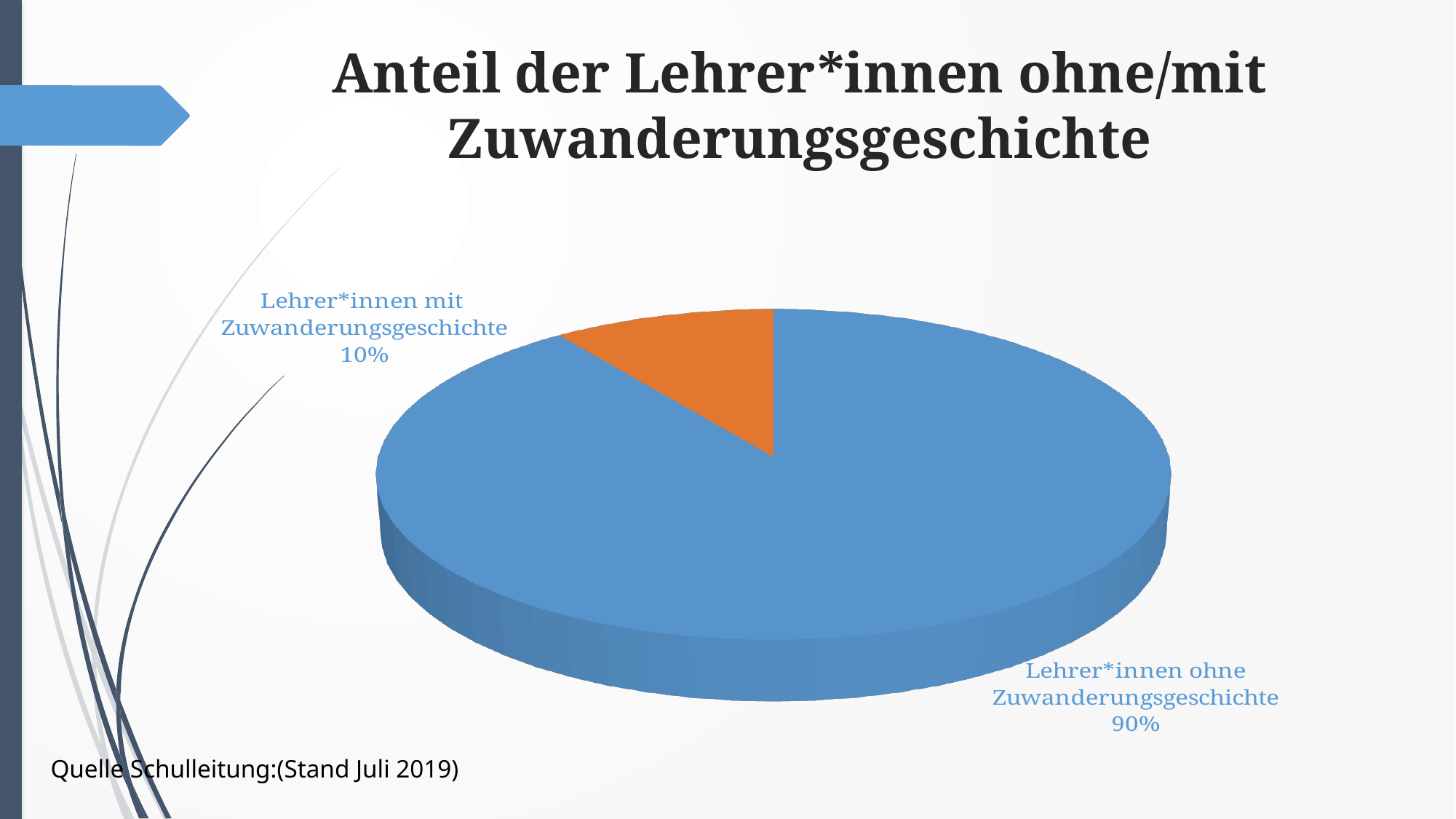
What kind of chart is shown on the slide? Pie chart What is the difference in percentage points between the share of Lehrer*innen ohne Zuwanderungsgeschichte and Lehrer*innen mit Zuwanderungsgeschichte? 80 percentage points Which slice of the pie is the largest? Lehrer*innen ohne Zuwanderungsgeschichte Is the share of Lehrer*innen ohne Zuwanderungsgeschichte greater or less than 50%? greater How many slices does the pie chart have? 2 Which slice of the pie is the smallest? Lehrer*innen mit Zuwanderungsgeschichte What is the title of the chart on the slide? Anteil der Lehrer*innen ohne/mit Zuwanderungsgeschichte What share of the pie is labelled "Lehrer*innen ohne Zuwanderungsgeschichte"? 90% What colour is the slice for Lehrer*innen mit Zuwanderungsgeschichte? Orange Which is larger: the share of Lehrer*innen mit Zuwanderungsgeschichte or the share of Lehrer*innen ohne Zuwanderungsgeschichte? Lehrer*innen ohne Zuwanderungsgeschichte What share of the pie is labelled "Lehrer*innen mit Zuwanderungsgeschichte"? 10%